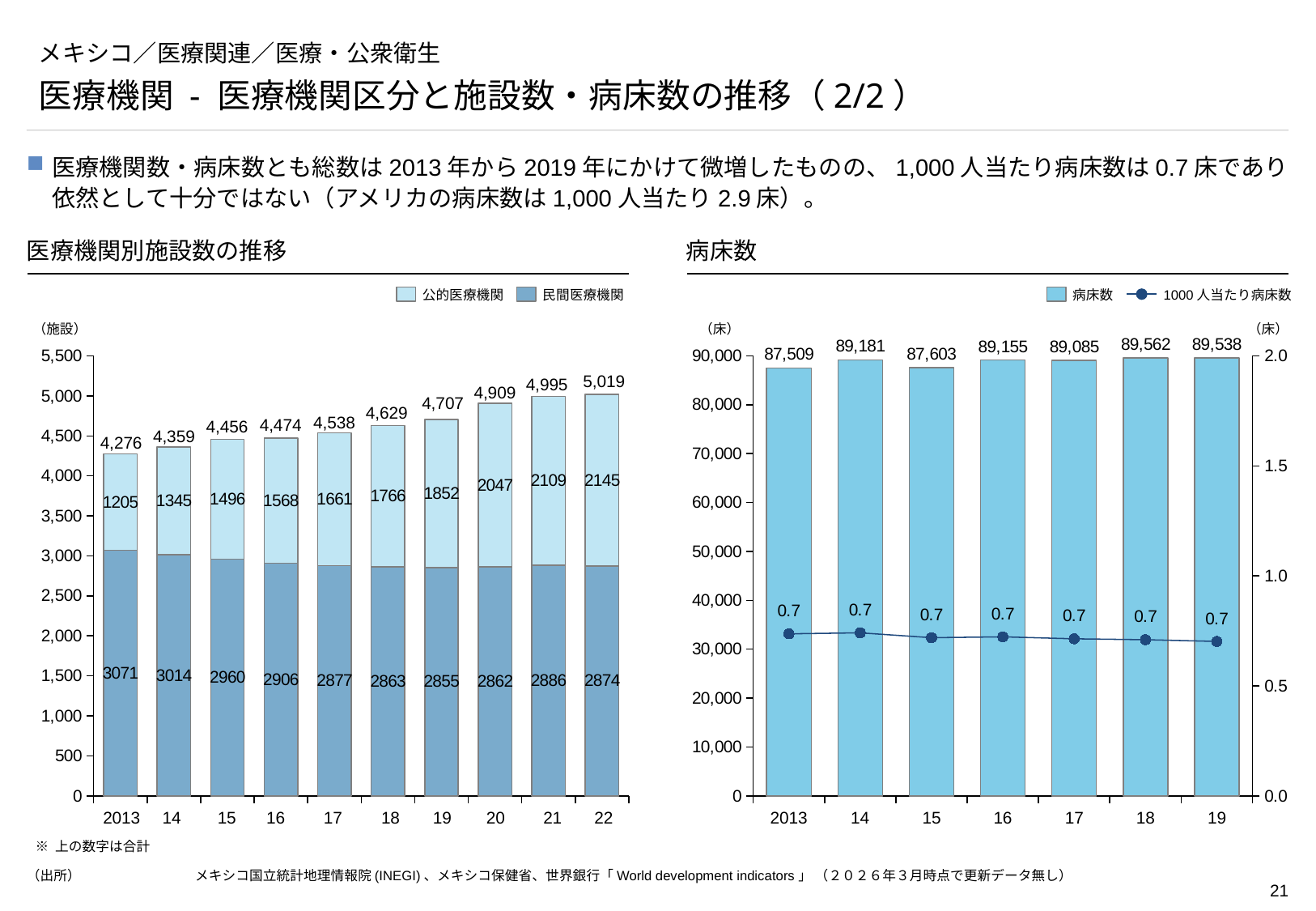
In the 医療機関別施設数の推移 chart, what is the total number of facilities shown for 2022? 5,019 How many series does the legend of the 病床数 chart list? 2 In the 医療機関別施設数の推移 chart, which year has the highest total number of facilities? 2022 In the 医療機関別施設数の推移 chart, what is the difference between the 2022 total and the 2013 total? 743 In the 病床数 chart, what is the difference in 病床数 between 2014 and 2013? 1,672 In the 医療機関別施設数の推移 chart, how many years (bars) are plotted? 10 In the 医療機関別施設数の推移 chart, what is the value for 民間医療機関 in 2019? 2855 What kind of chart is the 医療機関別施設数の推移 chart? stacked bar chart In the 医療機関別施設数の推移 chart, does the value for 公的医療機関 rise or fall from 2013 to 2022? rise In the 医療機関別施設数の推移 chart, what is the value for 公的医療機関 in 2013? 1205 In the 病床数 chart, what is the number of beds (病床数) in 2018? 89,562 In the 病床数 chart, which year has the lowest 病床数? 2013